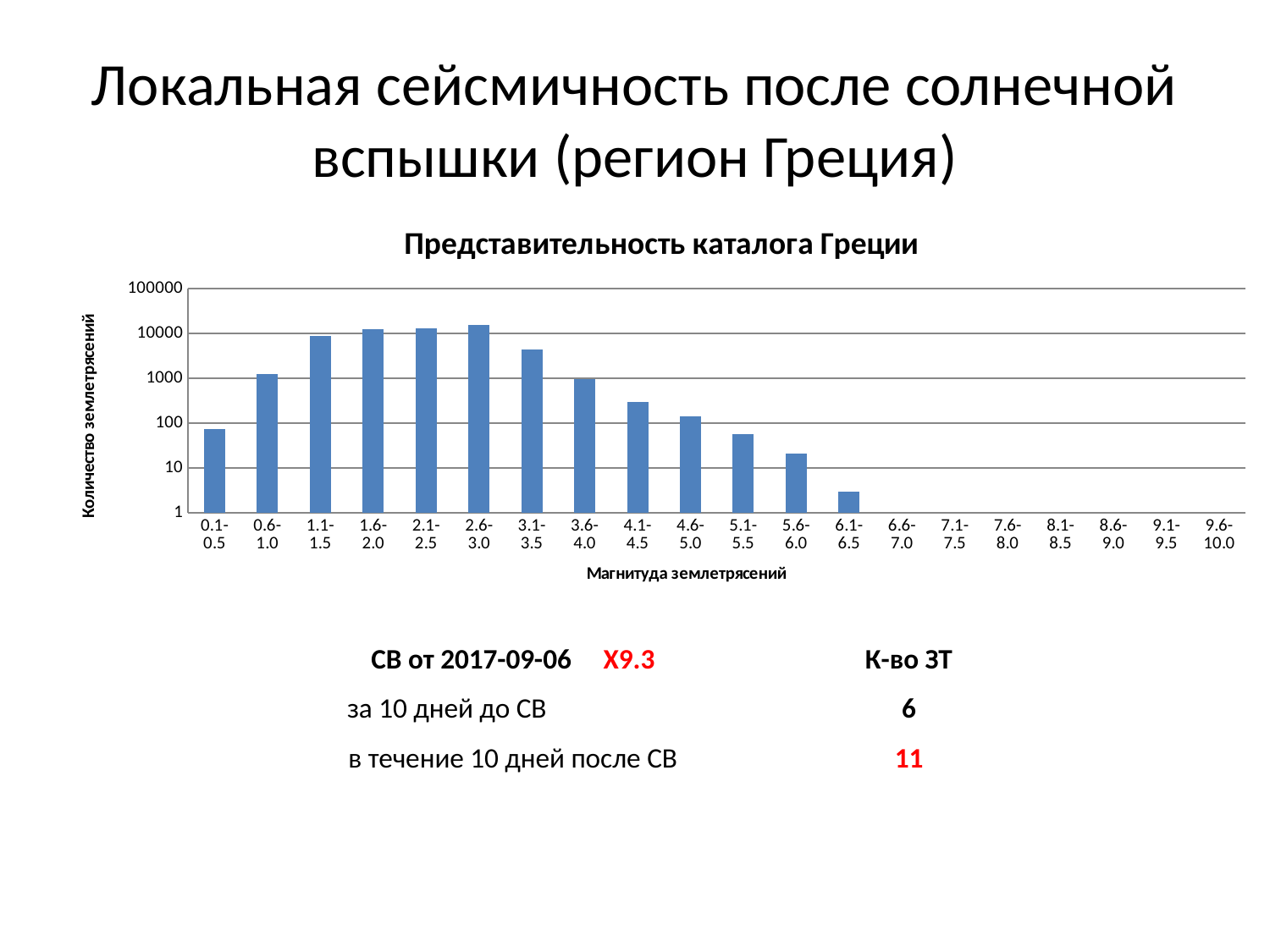
Which magnitude category has the highest bar in the chart? 2.6-3.0 What is the label of the vertical axis of the chart? Количество землетрясений Do the values in the chart rise or fall from the 3.1-3.5 category to the 6.1-6.5 category? fall How many magnitude categories are shown on the x axis of the chart? 20 What is the title of the chart? Представительность каталога Греции Is the value for the 4.1-4.5 magnitude category greater or less than 100? greater Which magnitude category has the lowest non-zero bar in the chart? 6.1-6.5 What kind of chart is shown on the slide? bar chart Is the value for the 0.1-0.5 magnitude category greater or less than 100? less Is the value for the 6.1-6.5 magnitude category greater or less than 10? less Which has the larger value in the chart, the 2.1-2.5 category or the 4.6-5.0 category? 2.1-2.5